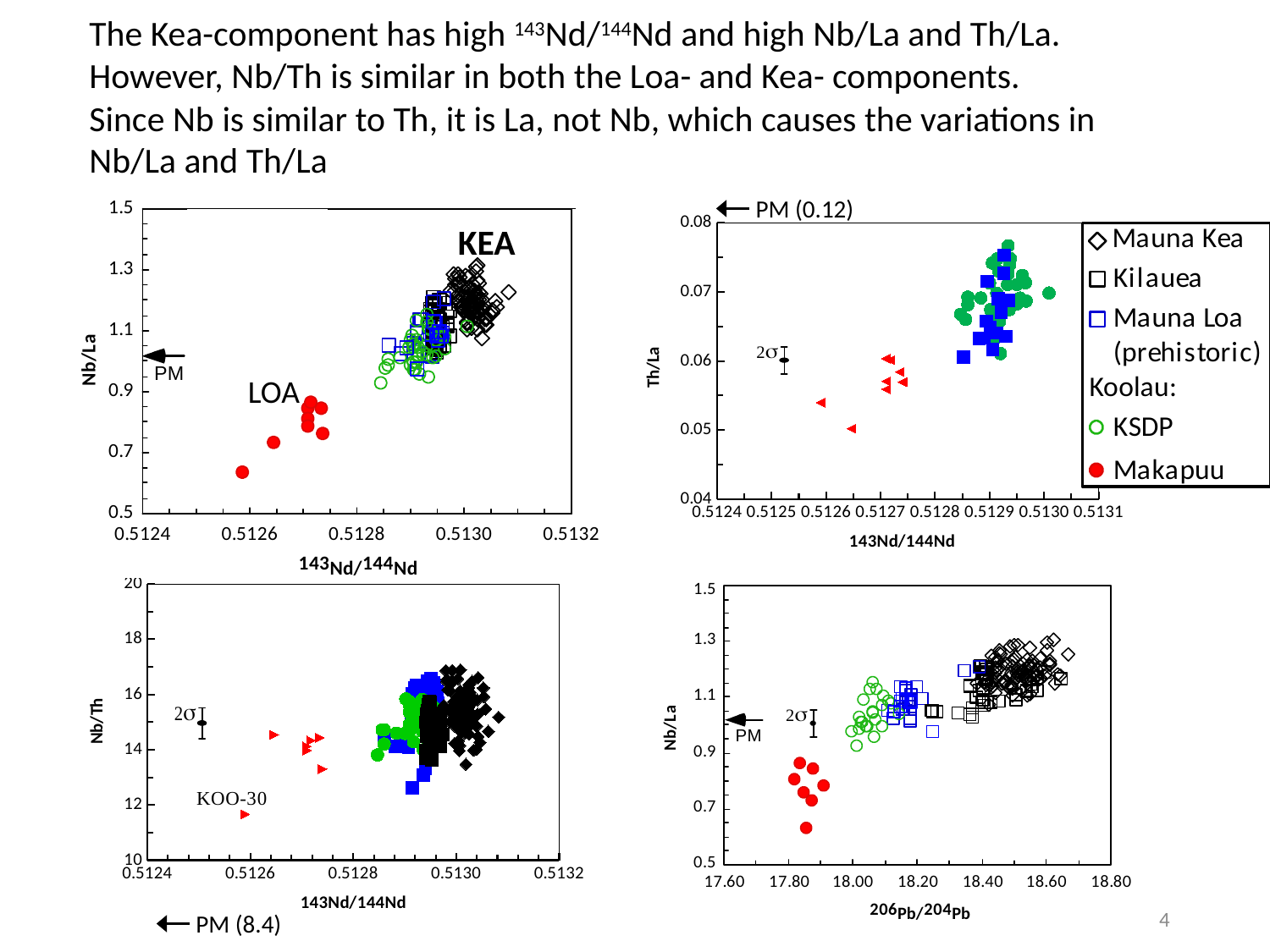
On the bottom-left chart (Nb/Th versus 143Nd/144Nd), what Nb/Th value is given for PM? 8.4 What kind of chart is the top-left chart (Nb/La versus 143Nd/144Nd)? scatter plot On the top-left chart, are the Nb/La values of the Makapuu (LOA) samples greater or less than 0.9? less On the bottom-right chart, does Nb/La rise or fall as 206Pb/204Pb increases? rise On the top-left chart, which group has higher Nb/La values: Mauna Kea (KEA) or Makapuu (LOA)? Mauna Kea (KEA) On the bottom-left chart, is the Nb/Th value of sample KOO-30 greater or less than 12? less What is the x-axis label of the bottom-right chart? 206Pb/204Pb How many sample groups does the legend on the top-right chart list? 5 On the top-right chart (Th/La versus 143Nd/144Nd), what Th/La value is given for PM? 0.12 On the bottom-right chart (Nb/La versus 206Pb/204Pb), are the Nb/La values of the Makapuu samples greater or less than 0.9? less How many charts are shown on the slide? 4